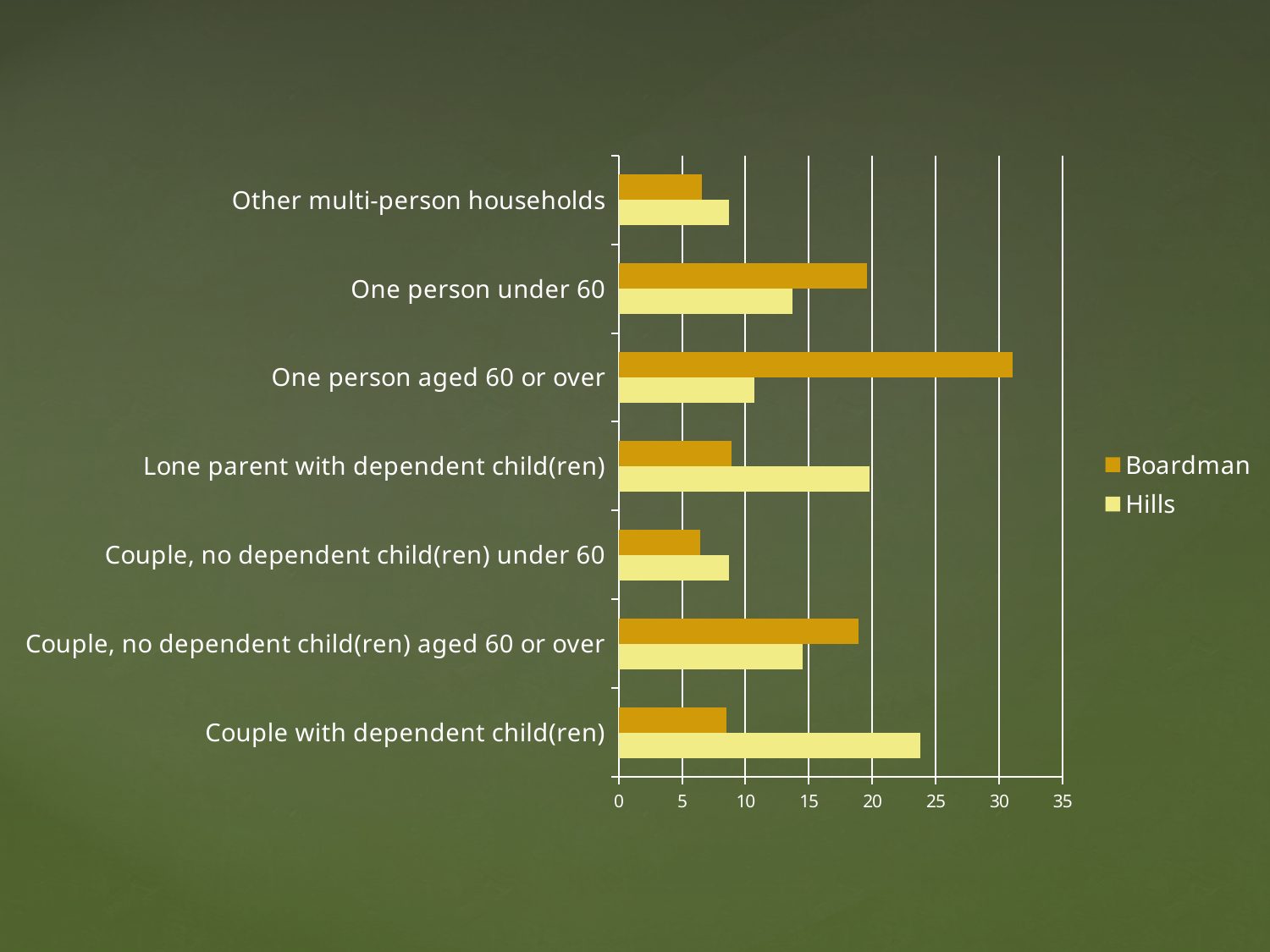
How many household categories are shown on the chart? 7 For One person under 60, which series has the larger value, Boardman or Hills? Boardman Is the Boardman value for One person aged 60 or over greater or less than 30? greater Which series is shown in the darker gold colour in the legend? Boardman Which category has the highest Boardman value? One person aged 60 or over What kind of chart is shown on the slide? bar chart Is the Hills value for Couple with dependent child(ren) greater or less than 20? greater Is the Hills value for One person aged 60 or over greater or less than 15? less Which category has the highest Hills value? Couple with dependent child(ren) For Lone parent with dependent child(ren), which series has the larger value, Boardman or Hills? Hills How many series does the legend list? 2